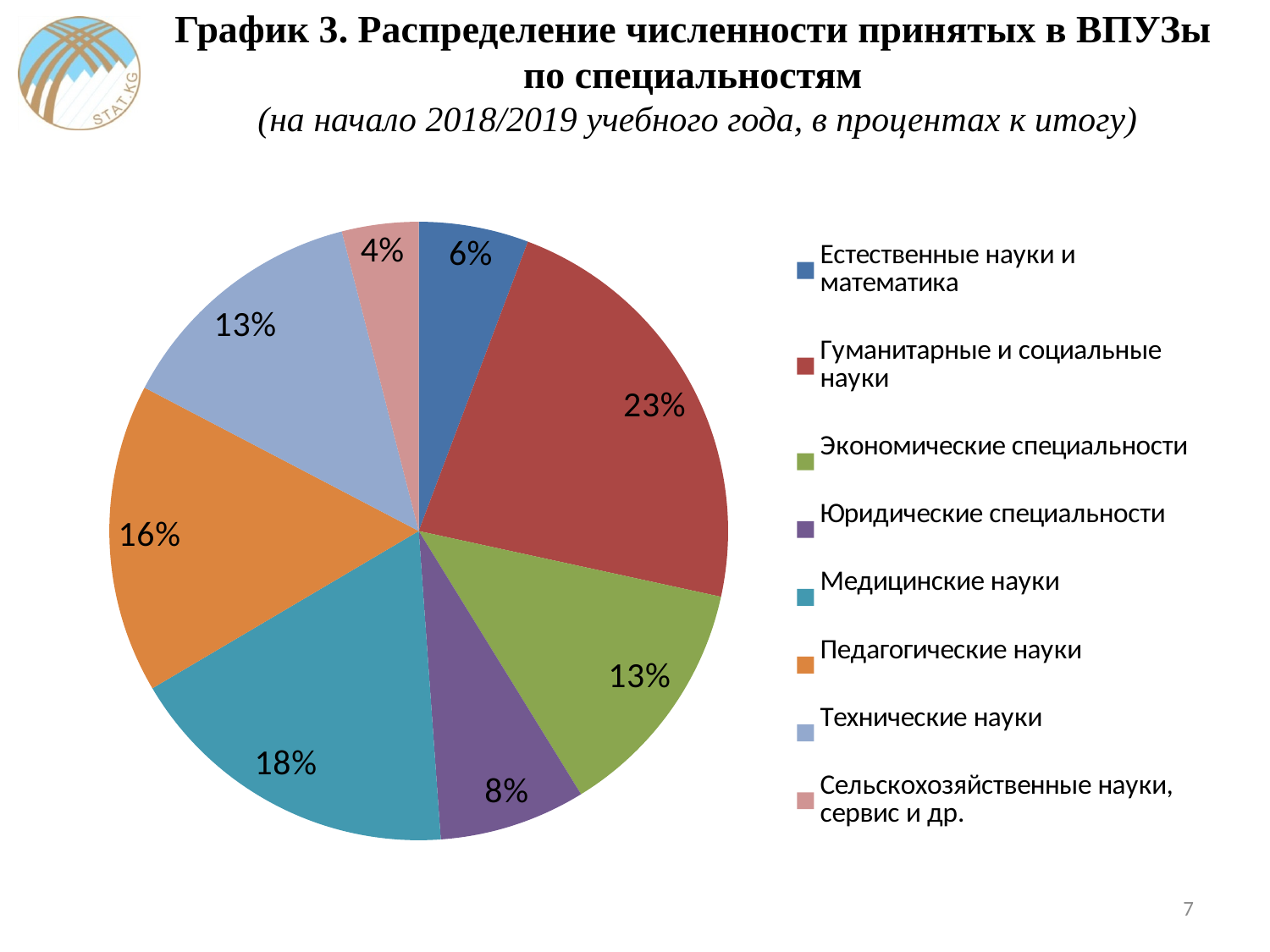
What share of the pie does Гуманитарные и социальные науки have? 23% What is the value shown for Медицинские науки? 18% What is the value shown for Юридические специальности? 8% Which academic year does the chart refer to, according to the title? 2018/2019 Which category has the largest slice of the pie? Гуманитарные и социальные науки Which category has the smallest slice of the pie? Сельскохозяйственные науки, сервис и др. What type of chart is shown on the slide? Pie chart What is the difference in percentage points between Медицинские науки and Естественные науки и математика? 12 What is the value shown for Сельскохозяйственные науки, сервис и др.? 4% Which is larger: the share for Педагогические науки or the share for Технические науки? Педагогические науки How many categories are shown in the pie chart? 8 What is the value shown for Педагогические науки? 16%